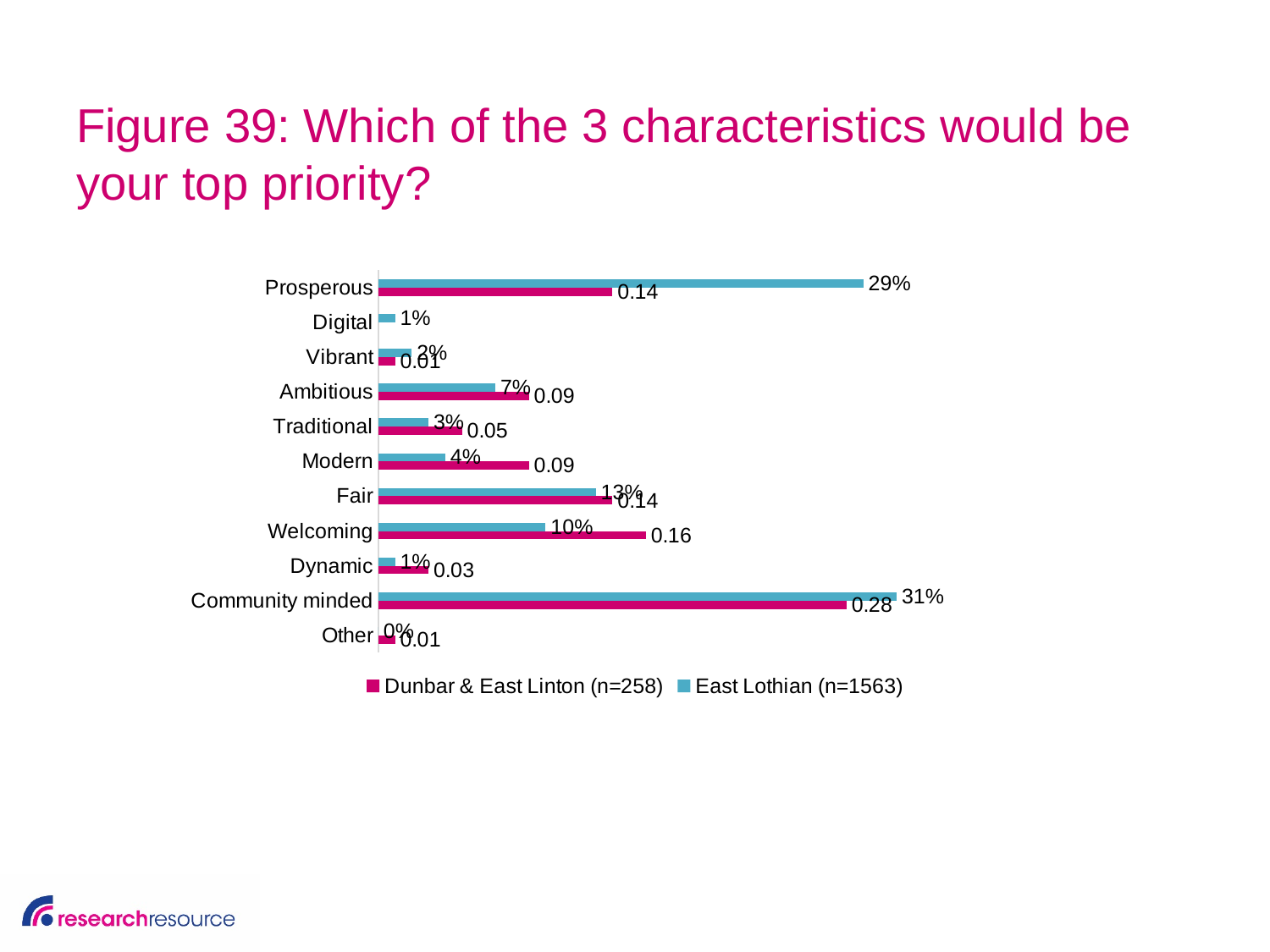
Which characteristic has the highest Dunbar & East Linton (n=258) value? Community minded Which colour represents the East Lothian (n=1563) series in the legend? blue What is the East Lothian (n=1563) value for Prosperous? 29% What is the Dunbar & East Linton (n=258) value for Welcoming? 0.16 What is the Dunbar & East Linton (n=258) value for Community minded? 0.28 How many series does the legend list? 2 How many characteristics (categories) are plotted on the chart? 11 What is the East Lothian (n=1563) value for Ambitious? 7% Which characteristic has the highest East Lothian (n=1563) value? Community minded What kind of chart is shown on the slide? bar chart What is the difference between the East Lothian (n=1563) values for Community minded and Prosperous? 2% For Welcoming, which series has the larger value: Dunbar & East Linton (n=258) or East Lothian (n=1563)? Dunbar & East Linton (n=258)